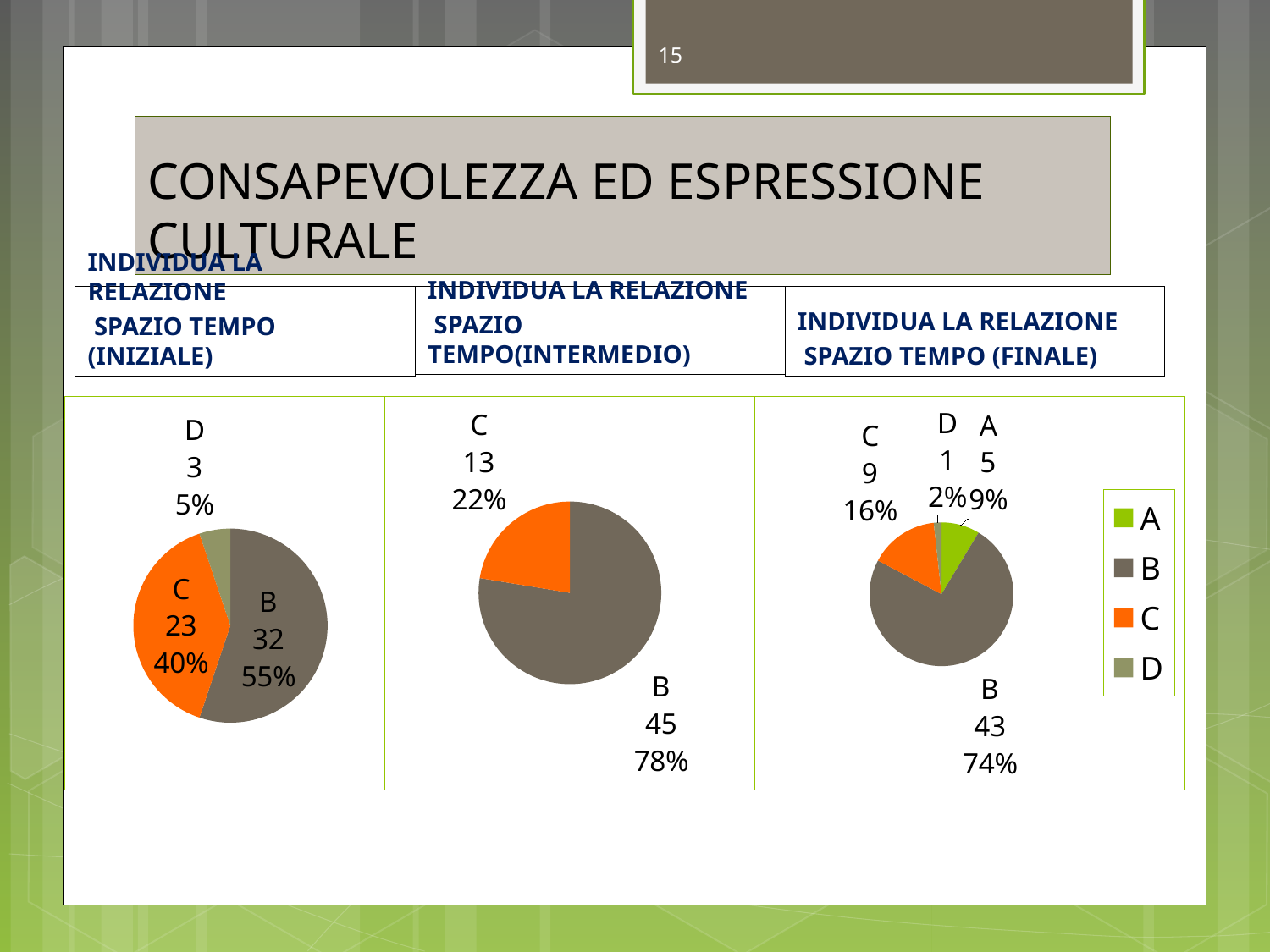
How many entries does the legend on the slide list? 4 In the FINALE (right) chart, what is the value for A? 5 In the INTERMEDIO (middle) chart, what share of the pie does B represent? 78% In the INTERMEDIO (middle) chart, what is the value for C? 13 In the FINALE (right) chart, is the value for C larger or smaller than the value for A? larger In the INIZIALE (left) chart, what is the value for B? 32 In the INIZIALE (left) chart, which category has the smallest slice? D In the FINALE (right) chart, which category has the largest slice? B In the INIZIALE (left) chart, what is the difference between the values for B and C? 9 What kind of chart is used in the INIZIALE (left) chart? pie chart How many slices does the INTERMEDIO (middle) chart have? 2 In the INIZIALE (left) chart, what share of the pie does C represent? 40%